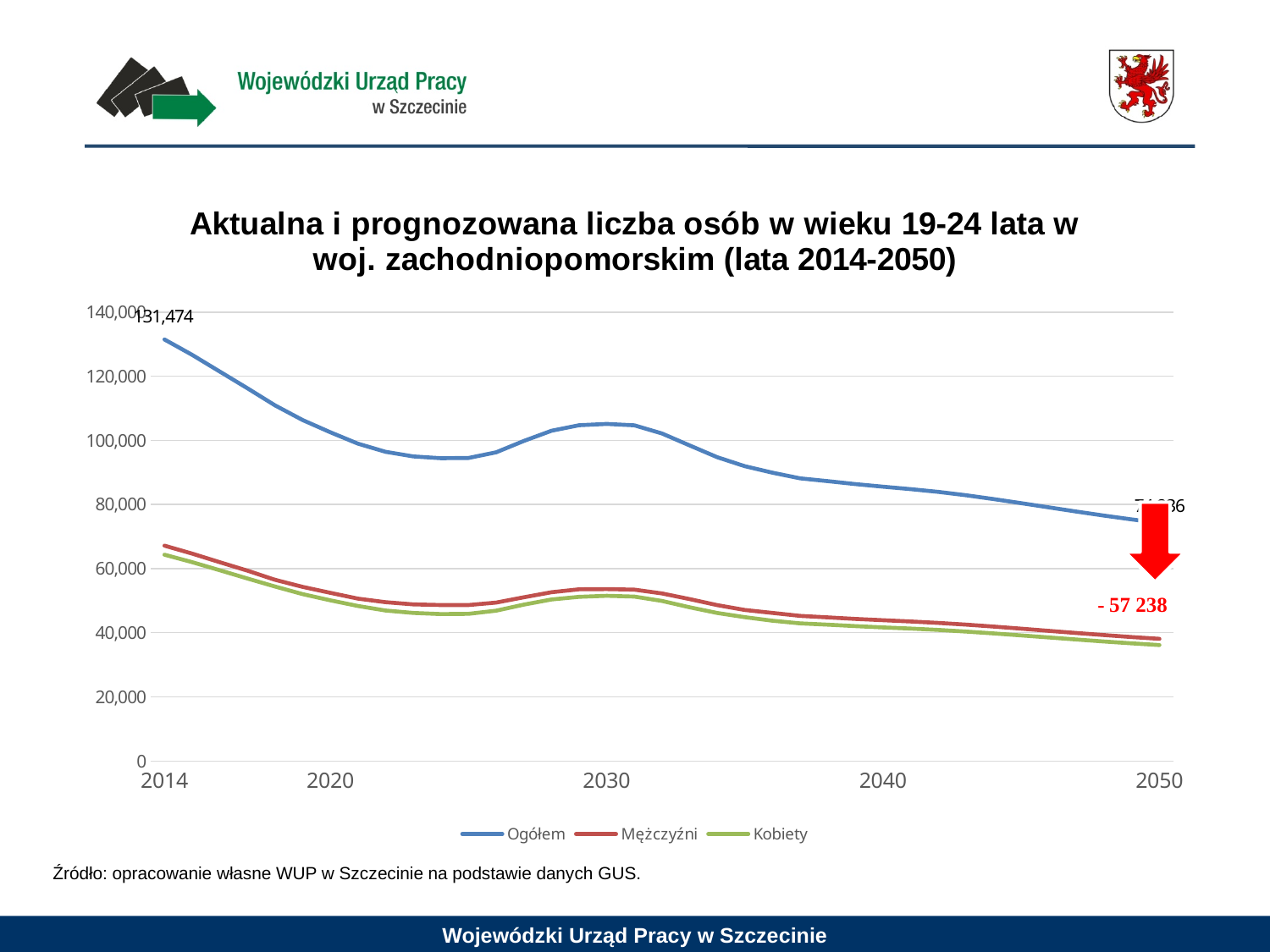
Is the value of the Mężczyźni series in 2014 greater or less than 60,000? greater What kind of chart is shown on the slide? line chart Is the value of the Ogółem series in 2030 greater or less than 100,000? greater Is the value of the Ogółem series in 2050 greater or less than 80,000? less In 2014, which series is higher: Mężczyźni or Kobiety? Mężczyźni Overall, does the Ogółem series rise or fall from 2014 to 2050? fall How many series does the legend list? 3 What change is shown in red next to the downward arrow at the right of the chart? - 57 238 Which series has the highest values across the whole period? Ogółem What is the value of the Ogółem series in 2014? 131,474